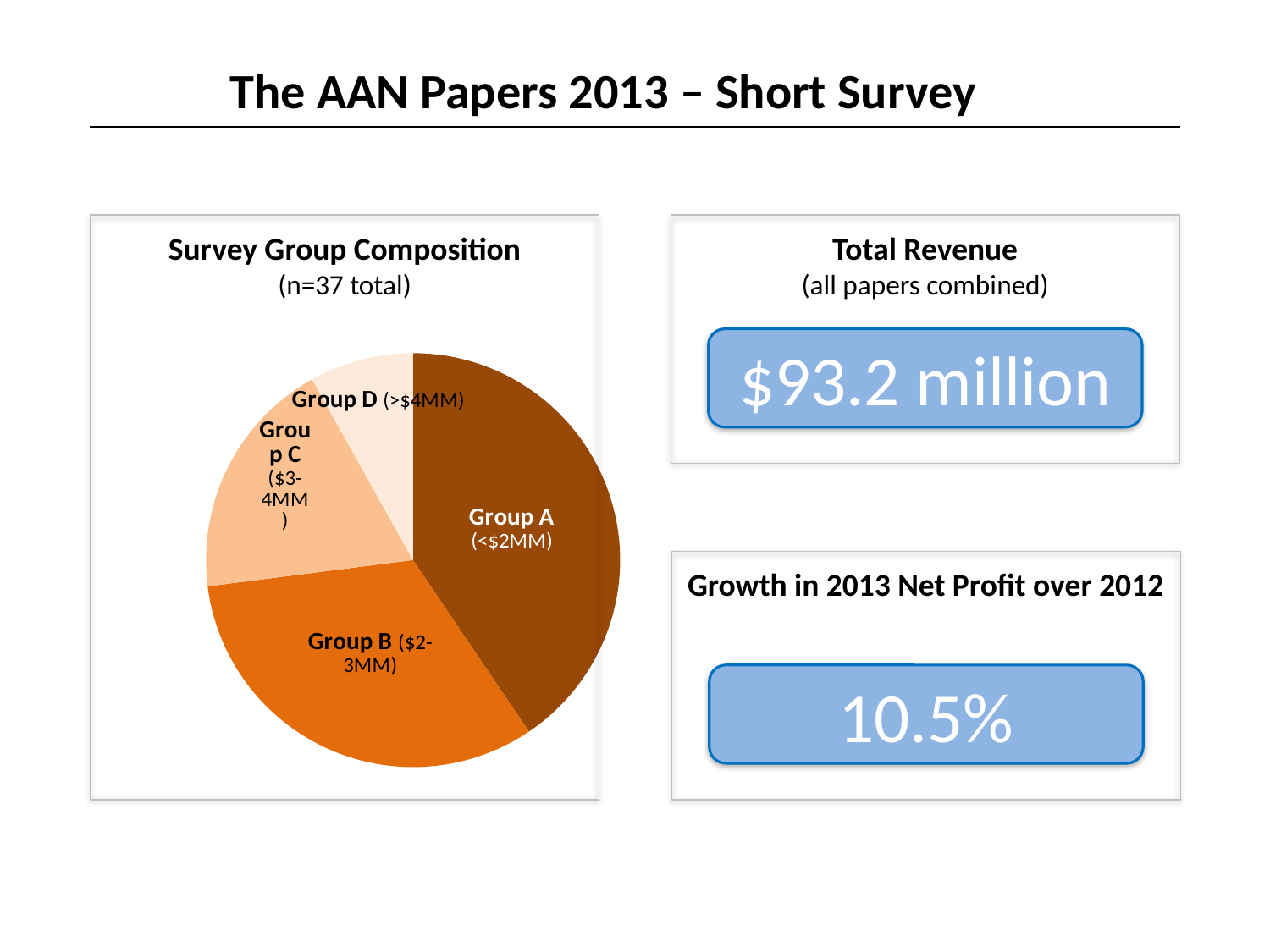
Which group has the largest slice in the Survey Group Composition pie chart? Group A In the Survey Group Composition pie chart, which slice is larger, Group A or Group B? Group A What is the title of the pie chart on the slide? Survey Group Composition In the Survey Group Composition pie chart, which slice is larger, Group B or Group C? Group B How many groups (slices) are shown in the Survey Group Composition pie chart? 4 According to the pie chart's subtitle, what is the total n for the survey group? 37 In the Survey Group Composition pie chart, which slice is larger, Group C or Group D? Group C Which group has the smallest slice in the Survey Group Composition pie chart? Group D What kind of chart is the Survey Group Composition chart? pie chart